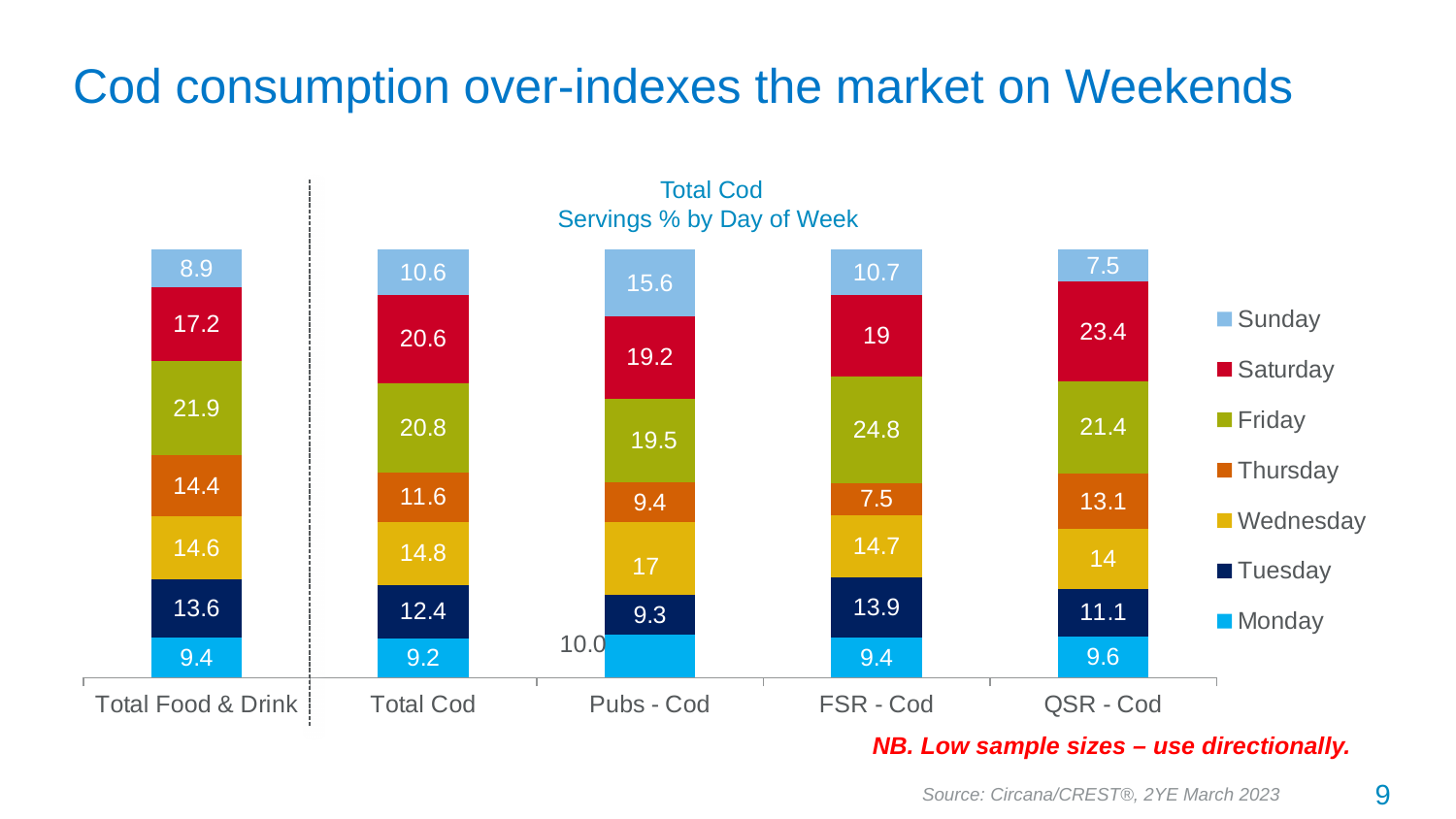
What kind of chart is shown on the slide? Stacked bar chart What is the Saturday value for QSR - Cod? 23.4 Which category has the highest Saturday value? QSR - Cod Which category has the lowest Sunday value? QSR - Cod What is the Sunday value for Pubs - Cod? 15.6 What is the Monday value for Total Food & Drink? 9.4 Which has the larger Saturday value, Total Cod or Total Food & Drink? Total Cod How many categories are shown on the x axis? 5 What is the difference between the Friday value for Total Food & Drink and the Friday value for Total Cod? 1.1 How many series does the legend list? 7 What is the difference between the Thursday value for Total Food & Drink and the Thursday value for FSR - Cod? 6.9 What is the Friday value for FSR - Cod? 24.8